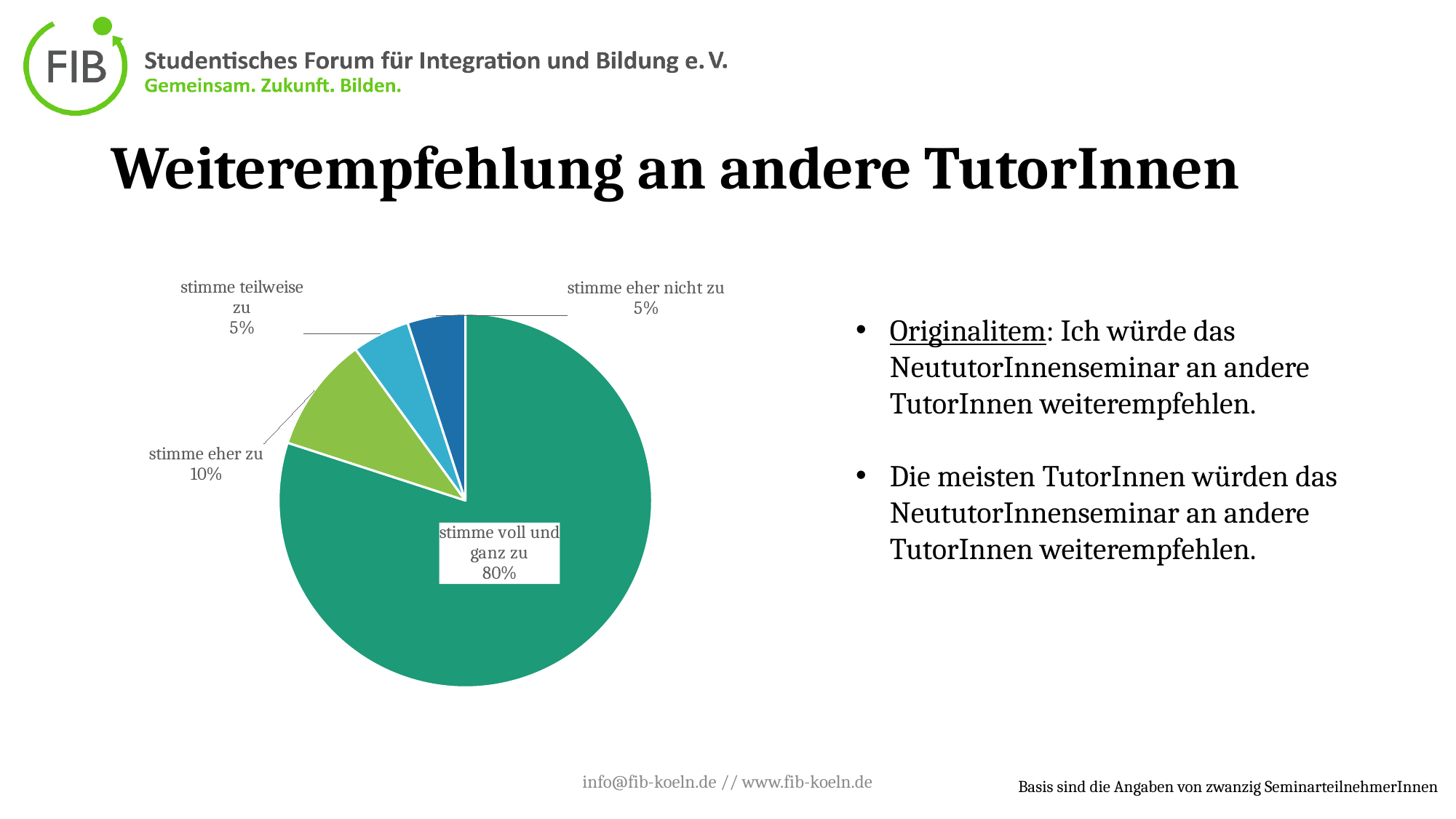
What is the combined share of "stimme teilweise zu" and "stimme eher nicht zu"? 10% What is the title of the slide containing the pie chart? Weiterempfehlung an andere TutorInnen What share of the pie is labelled "stimme teilweise zu"? 5% What colour is the largest slice of the pie chart? green Which is larger, the slice for "stimme eher zu" or the slice for "stimme teilweise zu"? stimme eher zu What share of the pie is labelled "stimme eher nicht zu"? 5% Which category has the largest slice of the pie? stimme voll und ganz zu What kind of chart is shown on the slide? pie chart What share of the pie is labelled "stimme eher zu"? 10% How many slices does the pie chart have? 4 What share of the pie is labelled "stimme voll und ganz zu"? 80% What is the difference in percentage points between "stimme voll und ganz zu" and "stimme eher zu"? 70